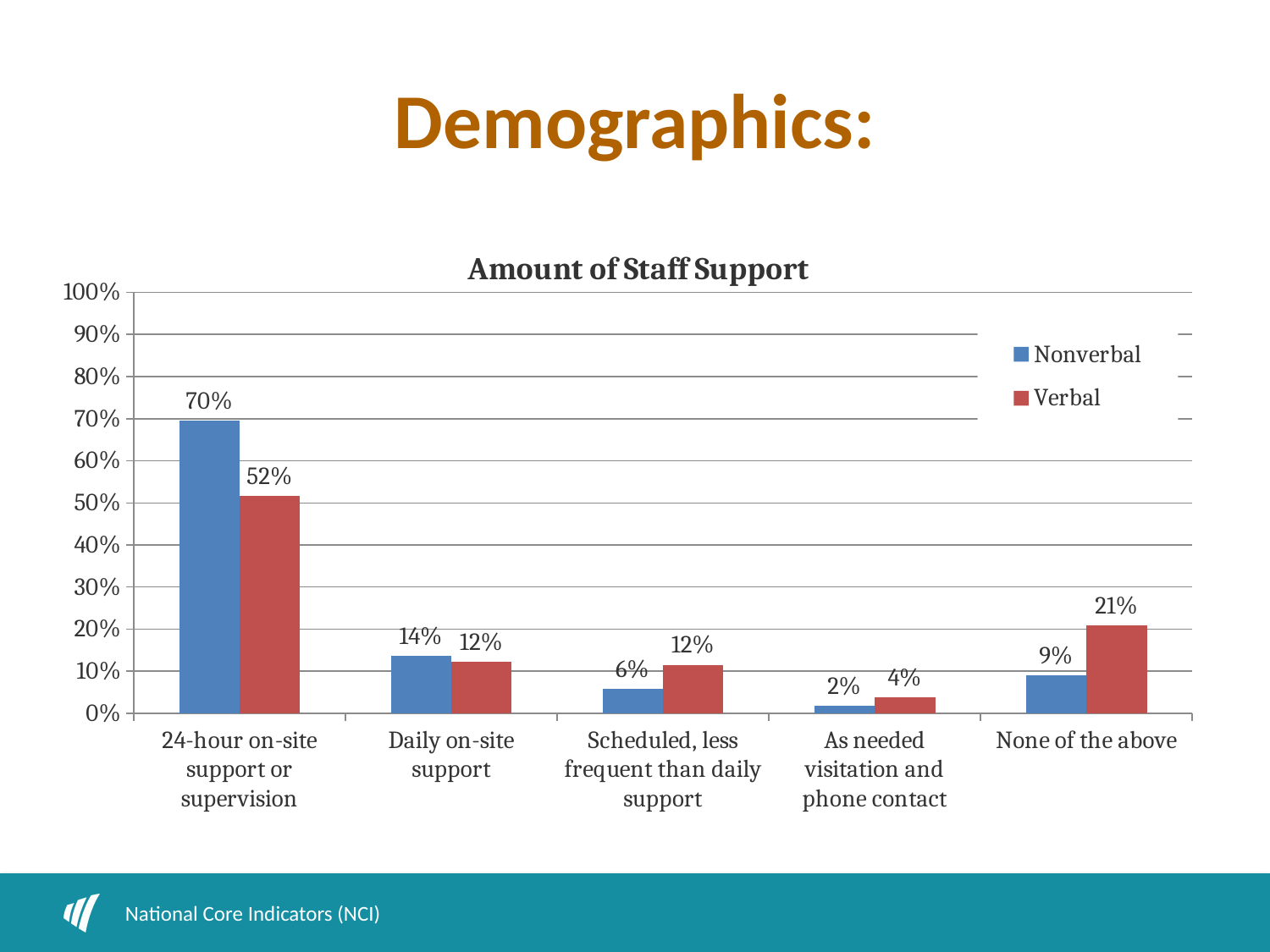
What is the Verbal value for Scheduled, less frequent than daily support? 12% Which category has the highest Verbal value? 24-hour on-site support or supervision Which is larger for Daily on-site support, the Nonverbal or the Verbal value? Nonverbal How many categories are shown on the x axis? 5 What is the difference between the Nonverbal and Verbal values for 24-hour on-site support or supervision? 18% What is the title of the chart? Amount of Staff Support What is the Nonverbal value for 24-hour on-site support or supervision? 70% What is the Verbal value for None of the above? 21% What is the difference between the Verbal and Nonverbal values for None of the above? 12% Which category has the lowest Nonverbal value? As needed visitation and phone contact How many series does the legend list? 2 What kind of chart is shown? Bar chart